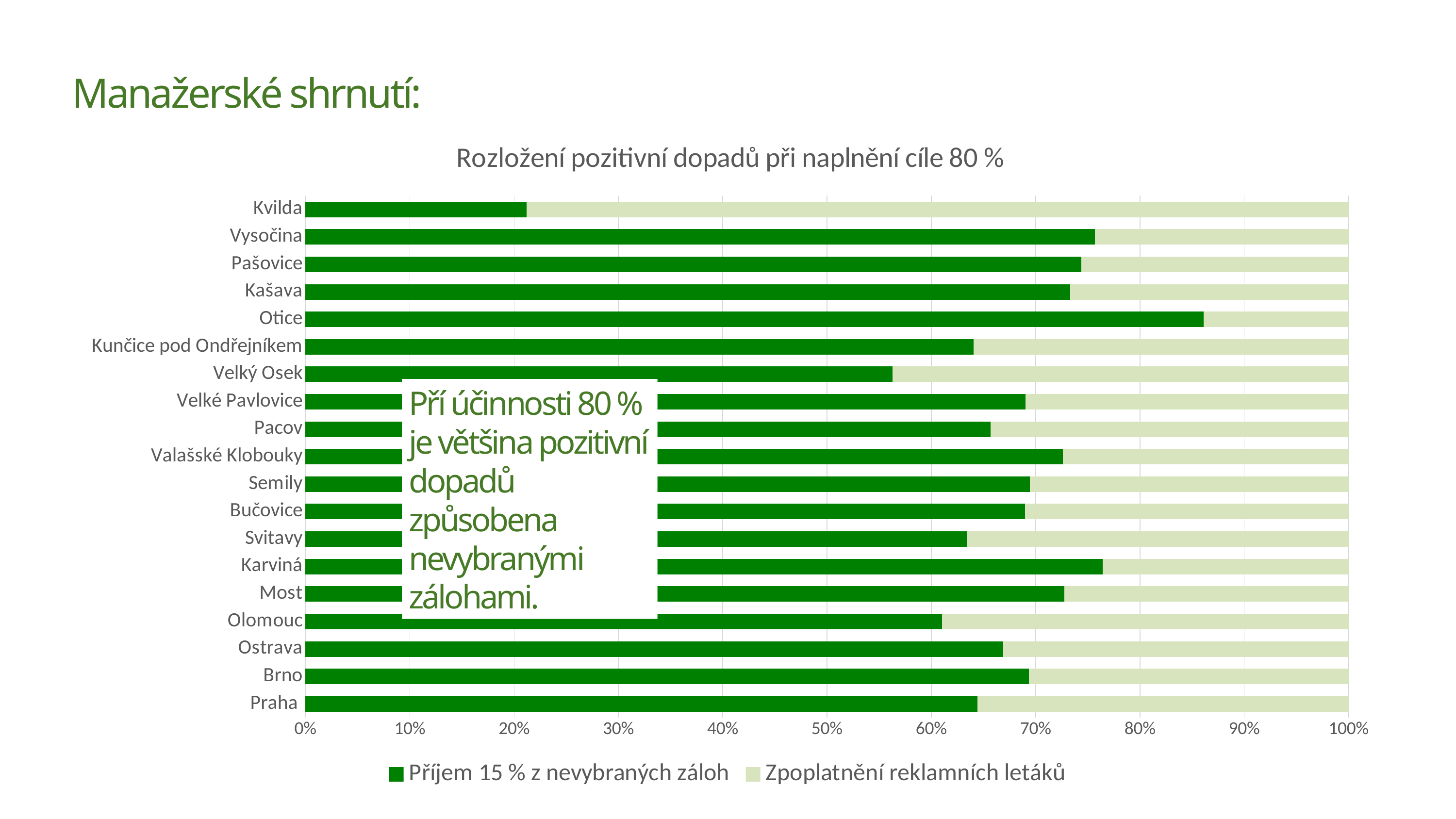
How many series does the legend list? 2 What kind of chart is shown on the slide? bar chart Is the 'Příjem 15 % z nevybraných záloh' share for Otice greater or less than 80%? greater Which series is shown in light green in the legend? Zpoplatnění reklamních letáků How many municipalities (categories) are plotted on the chart? 19 Is the 'Příjem 15 % z nevybraných záloh' share for Kvilda greater or less than 30%? less Is the 'Příjem 15 % z nevybraných záloh' share for Velký Osek greater or less than 60%? less What is the title of the chart? Rozložení pozitivní dopadů při naplnění cíle 80 % Which municipality has the highest share for 'Příjem 15 % z nevybraných záloh'? Otice Which municipality has the lowest share for 'Příjem 15 % z nevybraných záloh'? Kvilda Which has a larger 'Příjem 15 % z nevybraných záloh' share, Karviná or Velký Osek? Karviná